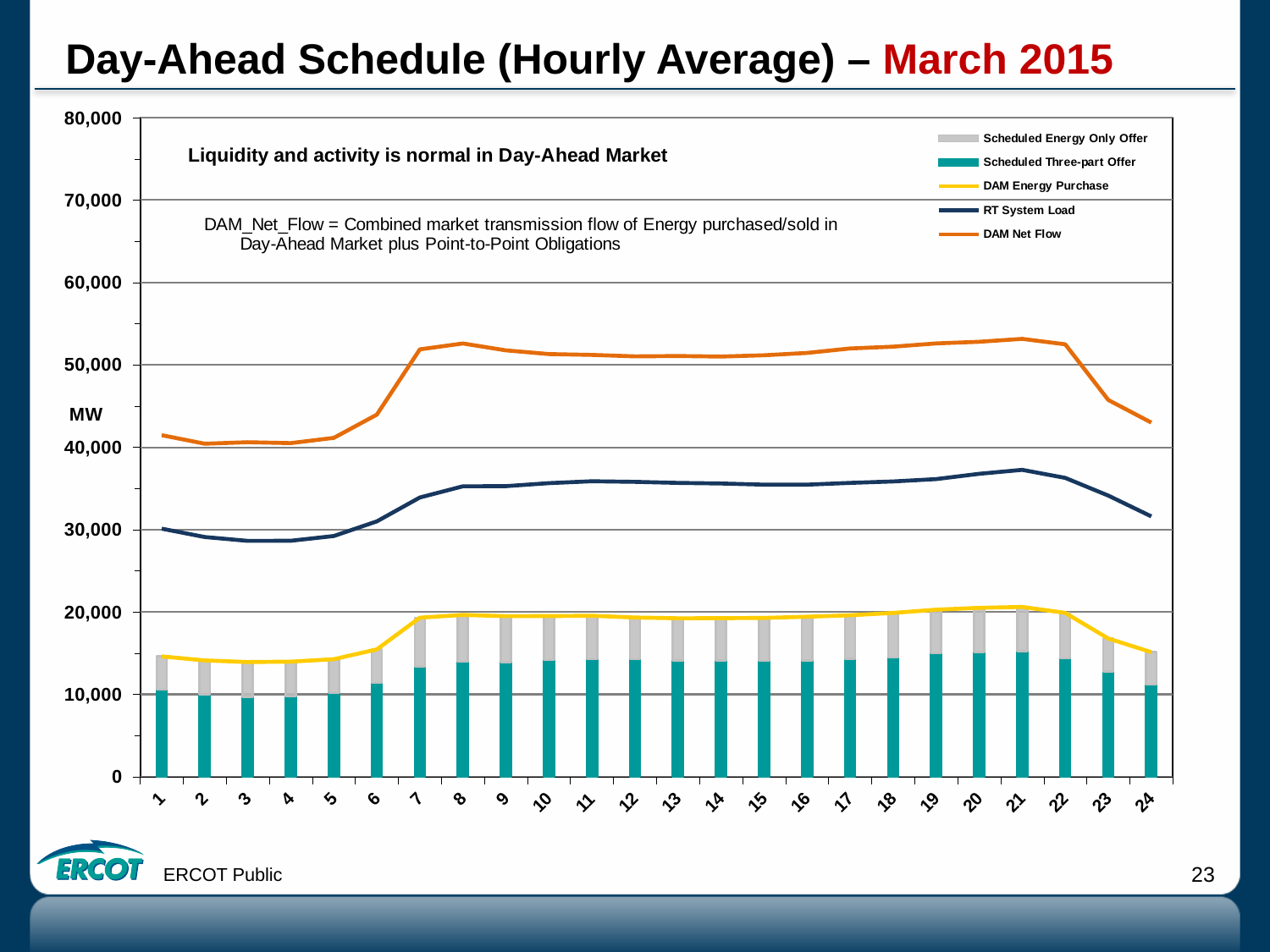
Is the Scheduled Three-part Offer value at hour 20 greater or less than 10,000? greater How many series does the legend list? 5 Is the DAM Net Flow value at hour 8 greater or less than 50,000? greater Which series is drawn as the orange line? DAM Net Flow Does DAM Net Flow rise or fall from hour 21 to hour 24? fall How many hours are shown along the x axis? 24 Which is larger, DAM Net Flow at hour 7 or DAM Net Flow at hour 1? Hour 7 Is the RT System Load value at hour 3 greater or less than 30,000? less At which hour does RT System Load reach its highest value? 21 At hour 12, which is larger, RT System Load or DAM Net Flow? DAM Net Flow What kind of chart is this? Combined bar and line chart